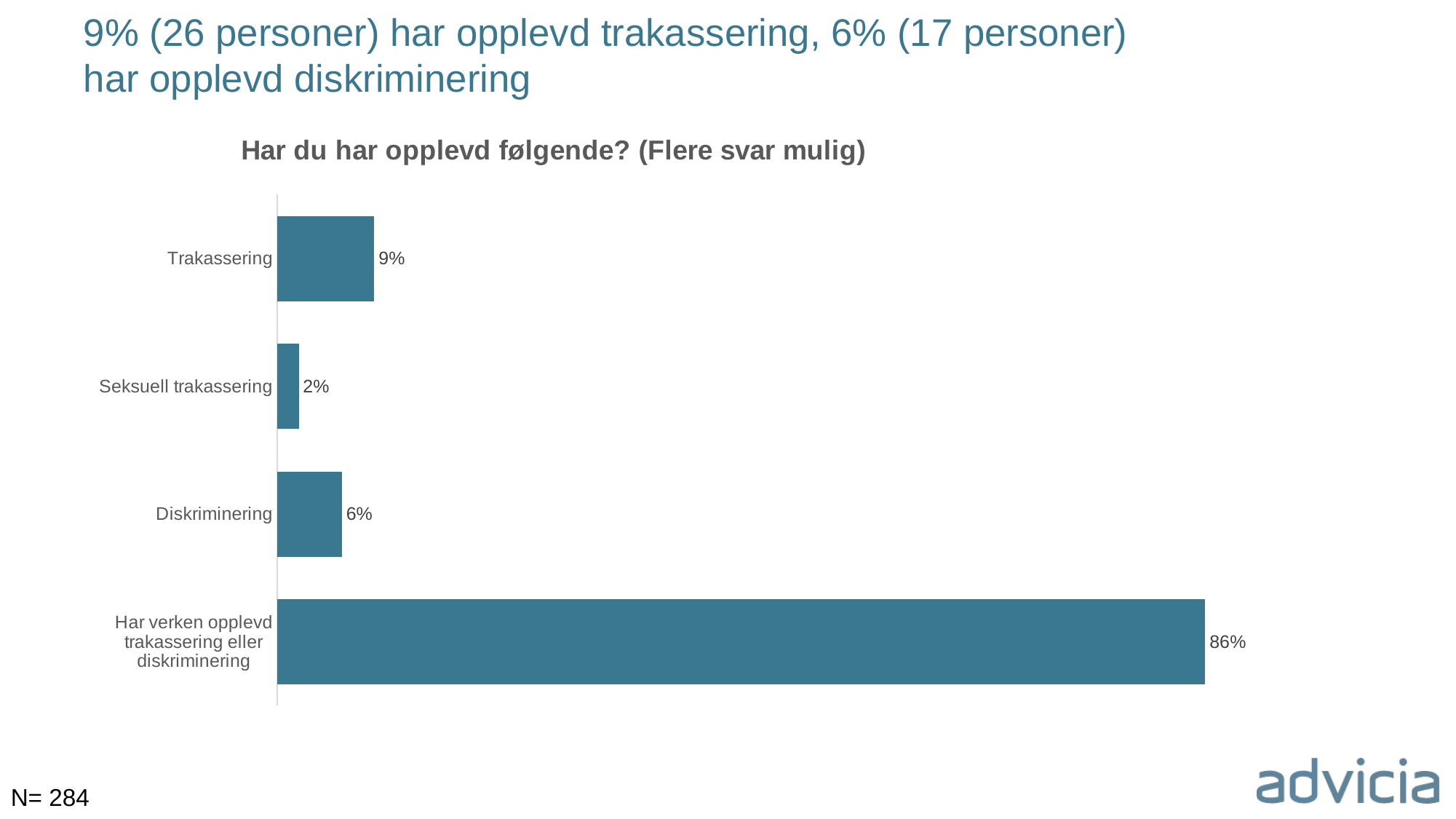
Which category has the lowest value? Seksuell trakassering What is the difference between the values for Trakassering and Diskriminering? 3% What is the value for 'Har verken opplevd trakassering eller diskriminering'? 86% Which is larger, the value for Diskriminering or the value for Seksuell trakassering? Diskriminering What is the value for Seksuell trakassering? 2% Which category has the highest value? Har verken opplevd trakassering eller diskriminering What is the value for Diskriminering? 6% What kind of chart is shown on the slide? Bar chart What is the sample size (N) stated on the slide? 284 How many categories are shown in the chart? 4 What is the value for Trakassering? 9% What is the title of the chart? Har du har opplevd følgende? (Flere svar mulig)